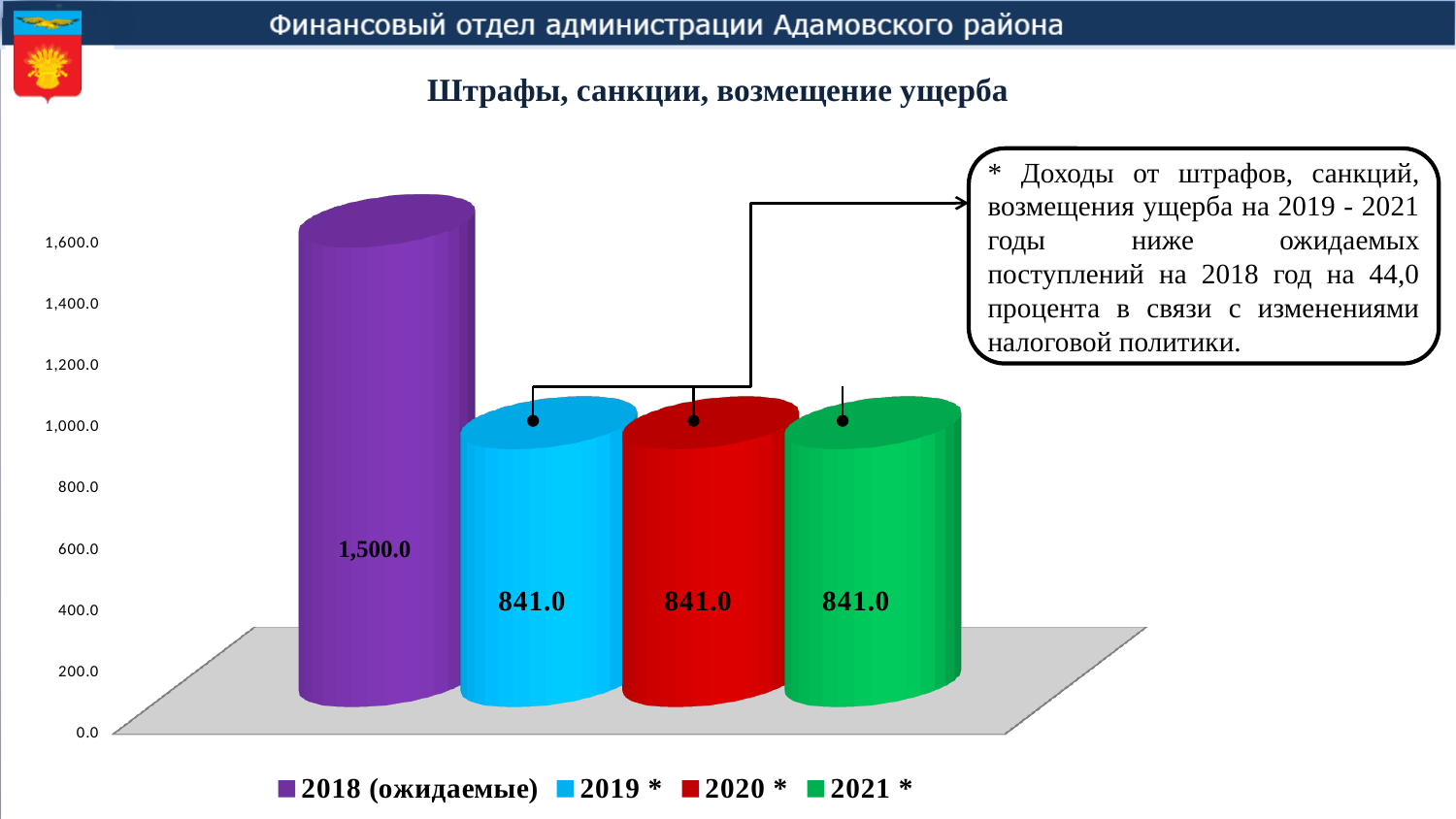
How many series does the legend list? 4 Which year has the highest value? 2018 (ожидаемые) What is the title of the chart? Штрафы, санкции, возмещение ущерба What is the value for 2021 *? 841.0 Is the value for 2018 (ожидаемые) greater or less than 1,200.0? greater What is the difference between the values for 2018 (ожидаемые) and 2020 *? 659.0 Which is larger, the value for 2018 (ожидаемые) or the value for 2019 *? 2018 (ожидаемые) Is the value for 2020 * greater or less than 1,000.0? less What is the value for 2018 (ожидаемые)? 1,500.0 What is the value for 2019 *? 841.0 What kind of chart is shown on the slide? bar chart How many bars are plotted on the chart? 4